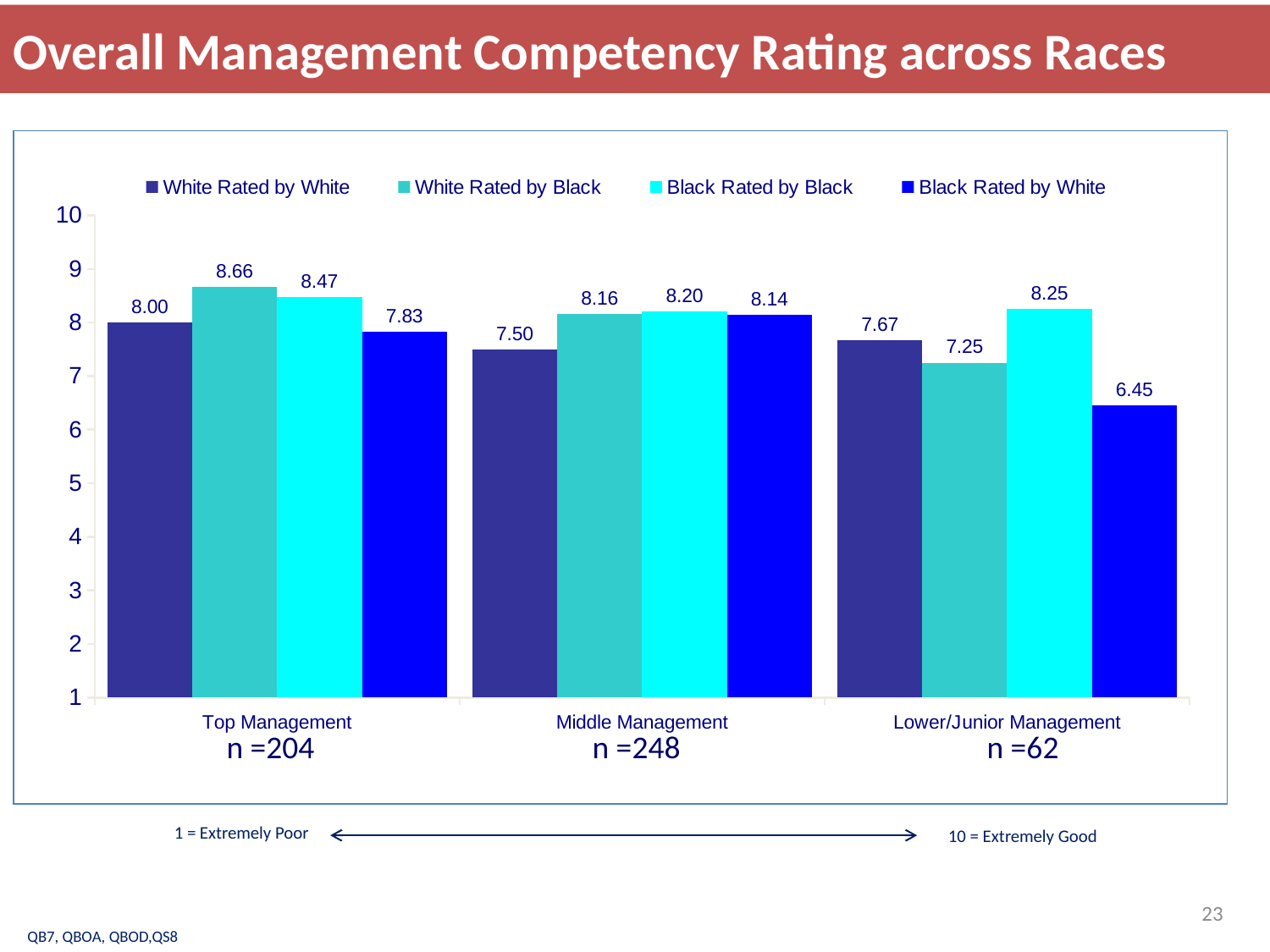
What is the difference between the White Rated by Black and Black Rated by White values in the Lower/Junior Management category? 0.80 Which is larger: White Rated by White for Top Management or White Rated by White for Lower/Junior Management? Top Management How many series does the legend list? 4 What is the value for Black Rated by White in the Lower/Junior Management category? 6.45 What is the title of the slide? Overall Management Competency Rating across Races What is the value for White Rated by Black in the Top Management category? 8.66 Which series has the highest value in the Lower/Junior Management category? Black Rated by Black What kind of chart is shown on the slide? Bar chart What is the sample size (n) shown for Middle Management? 248 Which series has the lowest value in the Top Management category? Black Rated by White How many management categories are shown on the x axis? 3 What is the value for White Rated by White in the Middle Management category? 7.50